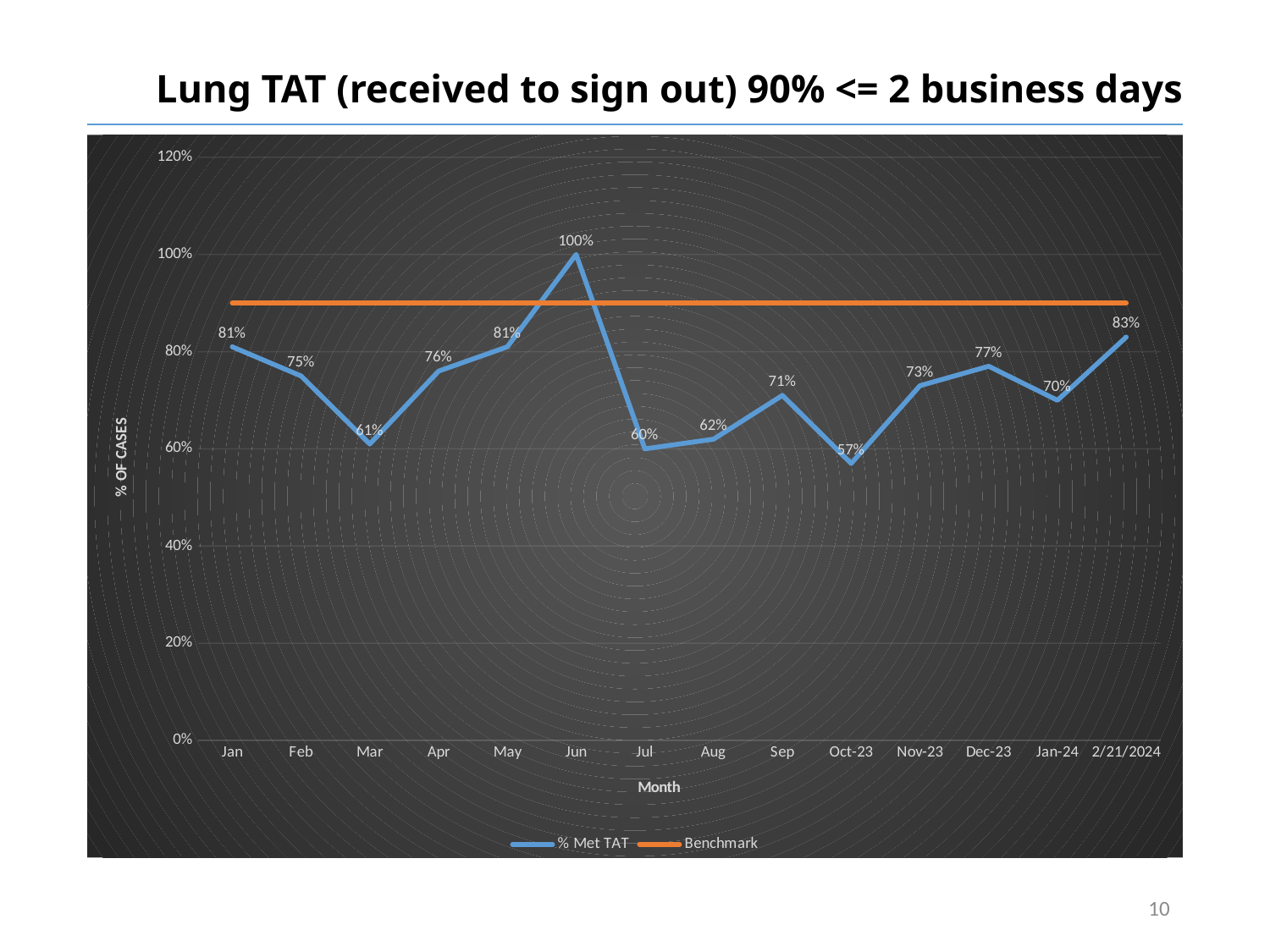
Which has a higher % Met TAT value, Sep or Nov-23? Nov-23 What is the % Met TAT value for 2/21/2024? 83% Is the Benchmark line greater or less than 80%? greater How many months are shown on the x axis? 14 How many series does the legend list? 2 Which month has the highest % Met TAT value? Jun What is the difference between the % Met TAT values for Jun and Jul? 40% What is the % Met TAT value for Oct-23? 57% What kind of chart is shown on the slide? line chart What is the % Met TAT value for Jun? 100% Which month has the lowest % Met TAT value? Oct-23 What is the title of the chart? Lung TAT (received to sign out) 90% <= 2 business days